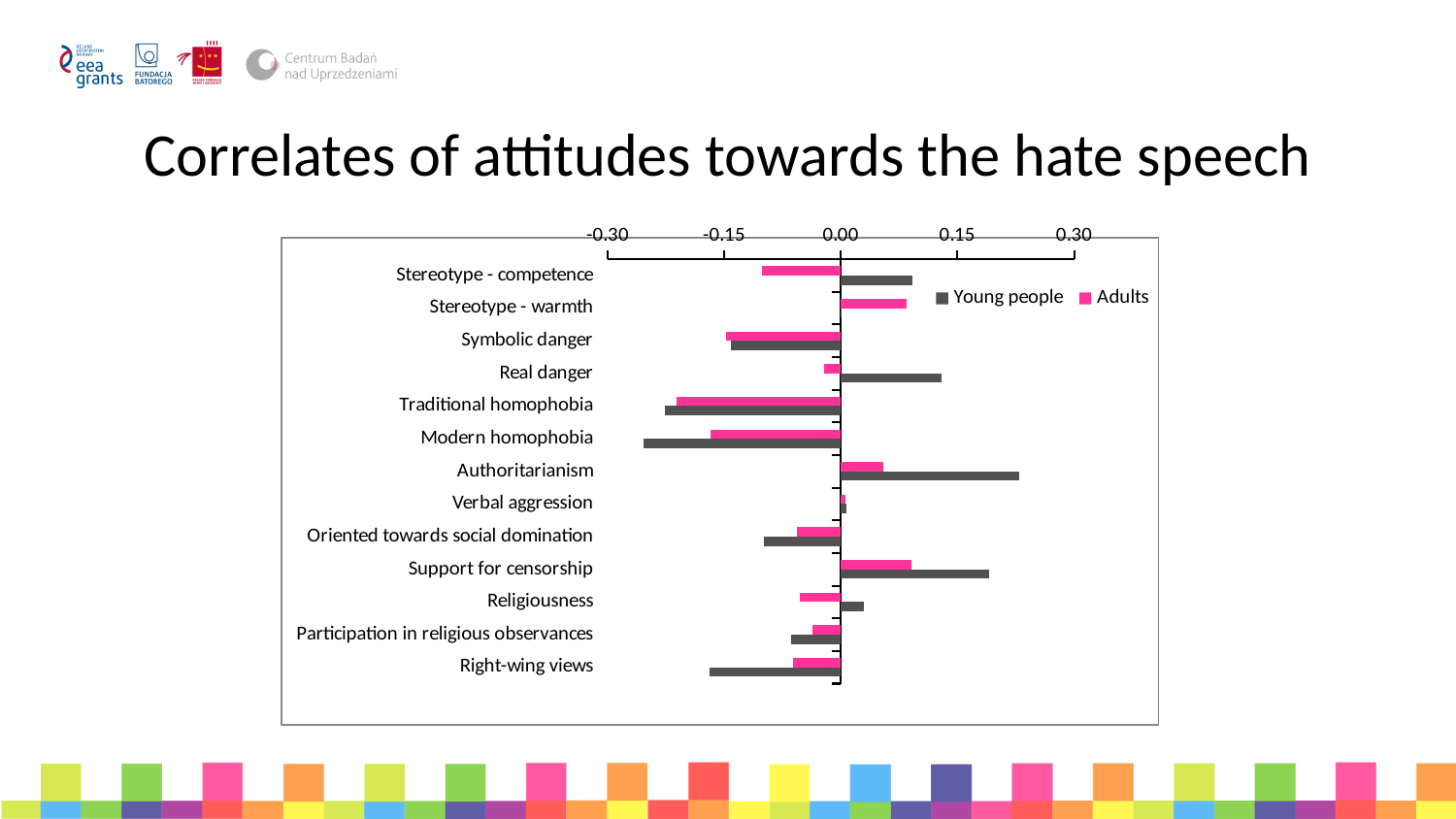
For the Adults series, which category has the lowest value? Traditional homophobia For the Young people series, which category has the lowest value? Modern homophobia How many series does the legend list? 2 Is the Adults value for Stereotype - warmth greater or less than 0.15? less How many categories are plotted on the chart? 13 Which colour represents the Adults series in the chart? pink What kind of chart is shown on the slide? bar chart Is the Young people value for Authoritarianism greater or less than 0.15? greater Is the Young people value for Modern homophobia greater or less than -0.15? less What is the title of the chart on the slide? Correlates of attitudes towards the hate speech For Authoritarianism, which series has the larger value, Young people or Adults? Young people For the Young people series, which category has the highest value? Authoritarianism